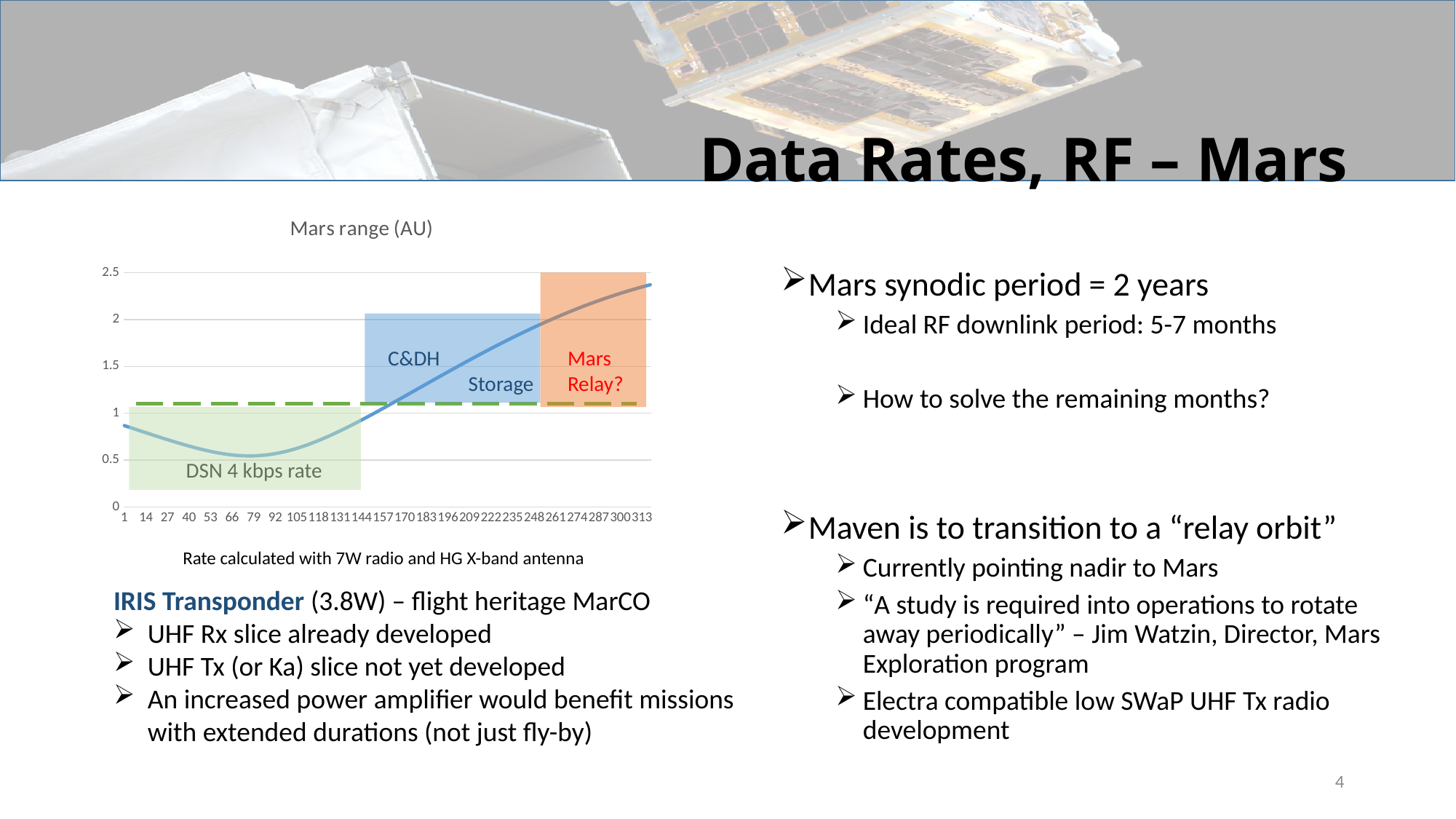
What is the title of the chart? Mars range (AU) Between x = 144 and x = 313, do the values of the Mars range line rise or fall? rise Is the value of the Mars range line at x = 1 greater or less than 1? less What is the highest tick value shown on the y axis of the chart? 2.5 Is the value of the Mars range line at x = 79 greater or less than 1? less Is the value of the Mars range line at x = 313 greater or less than 2? greater What kind of chart is shown on the slide? line chart How many tick labels are shown on the x axis of the chart? 25 Which is larger, the Mars range value at x = 1 or at x = 313? x = 313 Between x = 1 and x = 66, do the values of the Mars range line rise or fall? fall